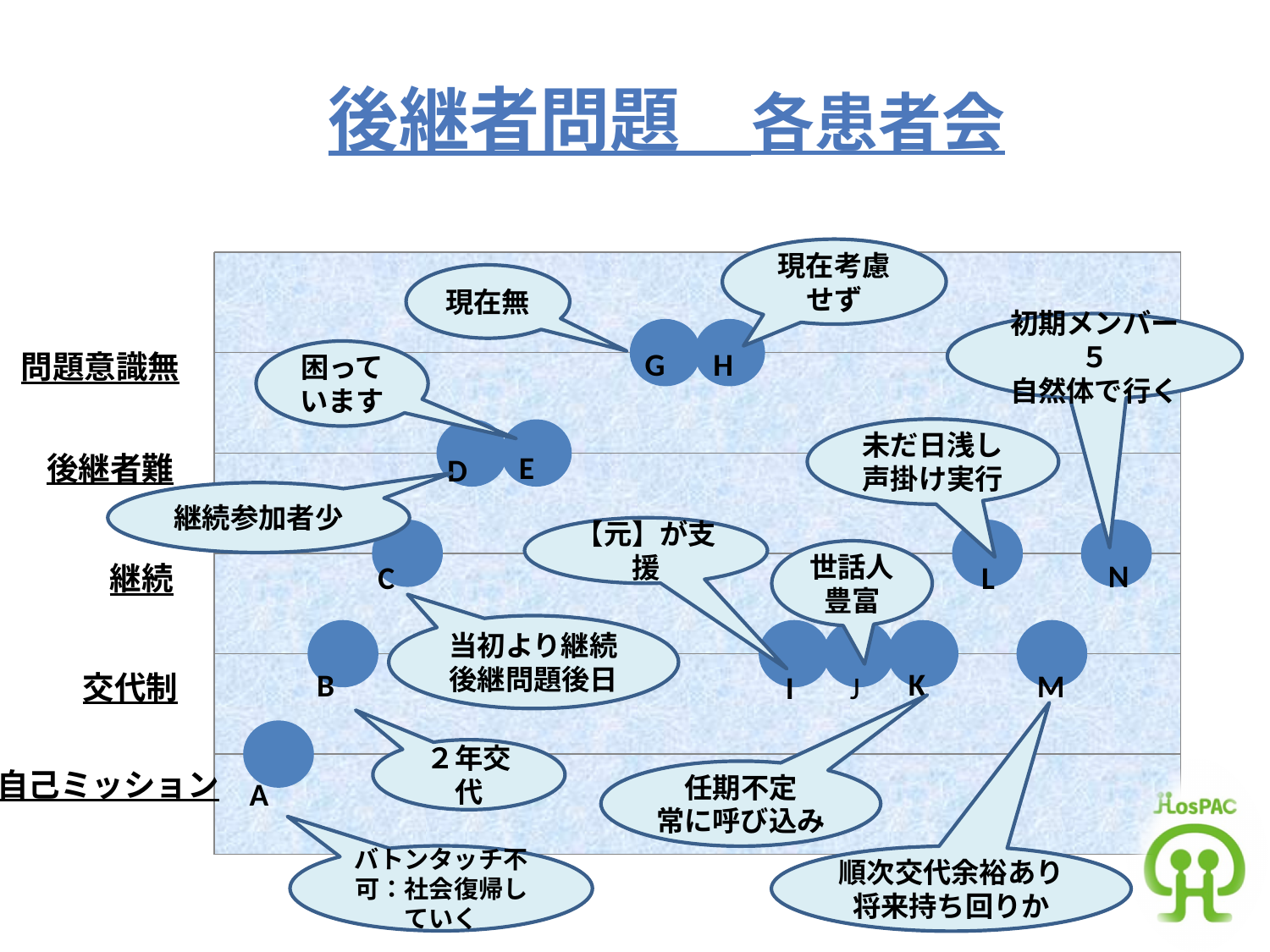
What is the title of the chart on the slide? 後継者問題 各患者会 Which row category is point N placed in? 継続 Which row category are points D and E placed in? 後継者難 How many points are placed in the 継続 row? 3 How many labelled points (circles) are plotted on the chart? 13 How many row categories are listed along the left side of the chart? 5 Which row category contains the most points? 交代制 What kind of chart is shown on the slide? bubble chart Which row category is point M placed in? 交代制 Which row category contains the fewest points? 自己ミッション Which row category are points G and H placed in? 問題意識無 Which row category is point A placed in? 自己ミッション